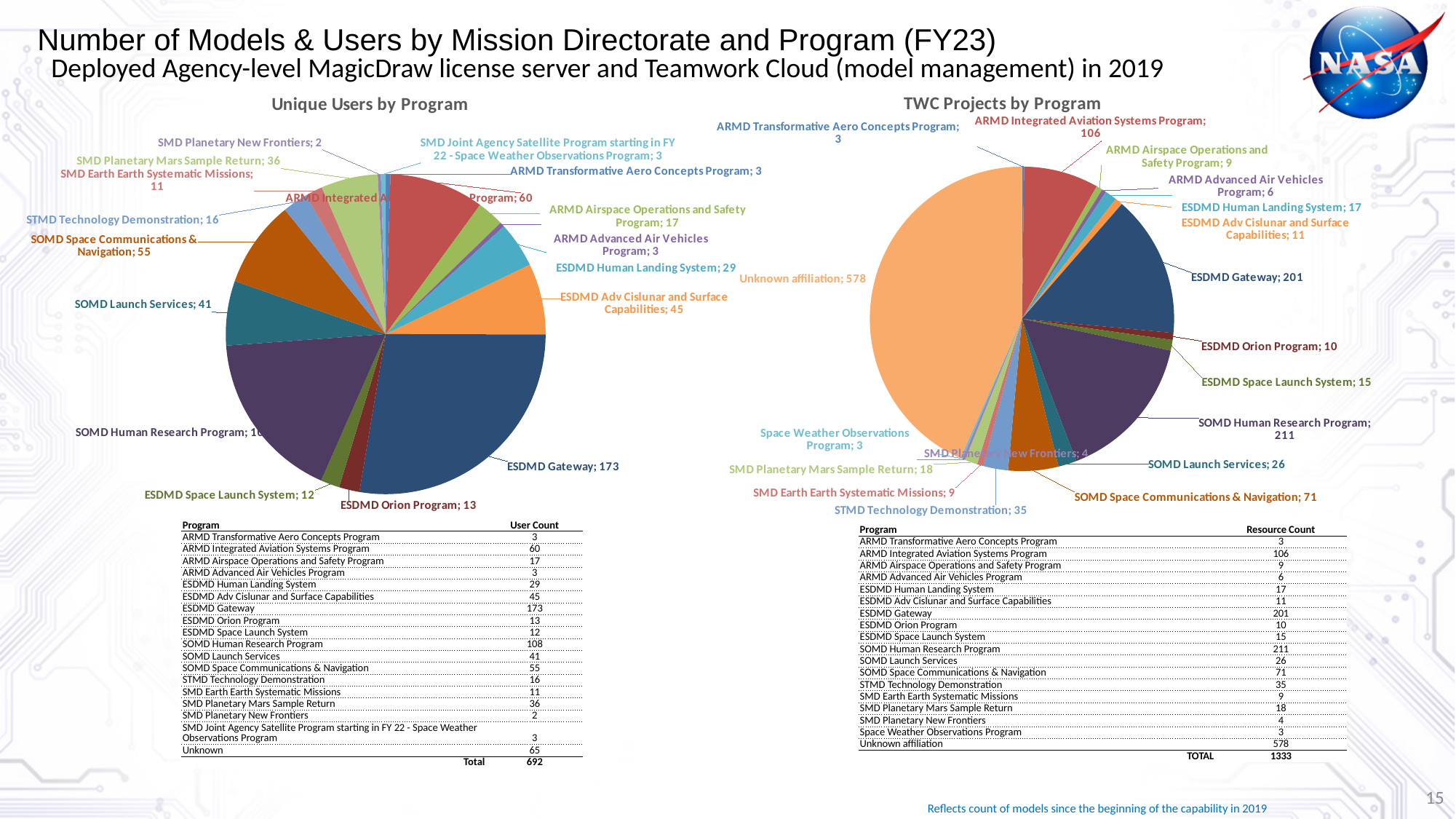
In the TWC Projects by Program pie chart, what is the difference between Unknown affiliation and SOMD Human Research Program? 367 In the Unique Users by Program pie chart, which program has the smallest value? SMD Planetary New Frontiers In the Unique Users by Program chart, what share of the total of 692 users does ESDMD Gateway (173) represent? 25% In the Unique Users by Program pie chart, what is the difference between ESDMD Gateway and SOMD Space Communications & Navigation? 118 In the TWC Projects by Program pie chart, what is the value for SOMD Human Research Program? 211 In the Unique Users by Program pie chart, how many unique users does ESDMD Gateway have? 173 What type of chart is used for Unique Users by Program? Pie chart In the Unique Users by Program pie chart, which program has the largest slice? ESDMD Gateway In the TWC Projects by Program pie chart, what is the value for Unknown affiliation? 578 What is the title of the chart on the right side of the slide? TWC Projects by Program In the TWC Projects by Program pie chart, which is larger: ESDMD Gateway or SOMD Human Research Program? SOMD Human Research Program In the TWC Projects by Program pie chart, which category has the largest slice? Unknown affiliation